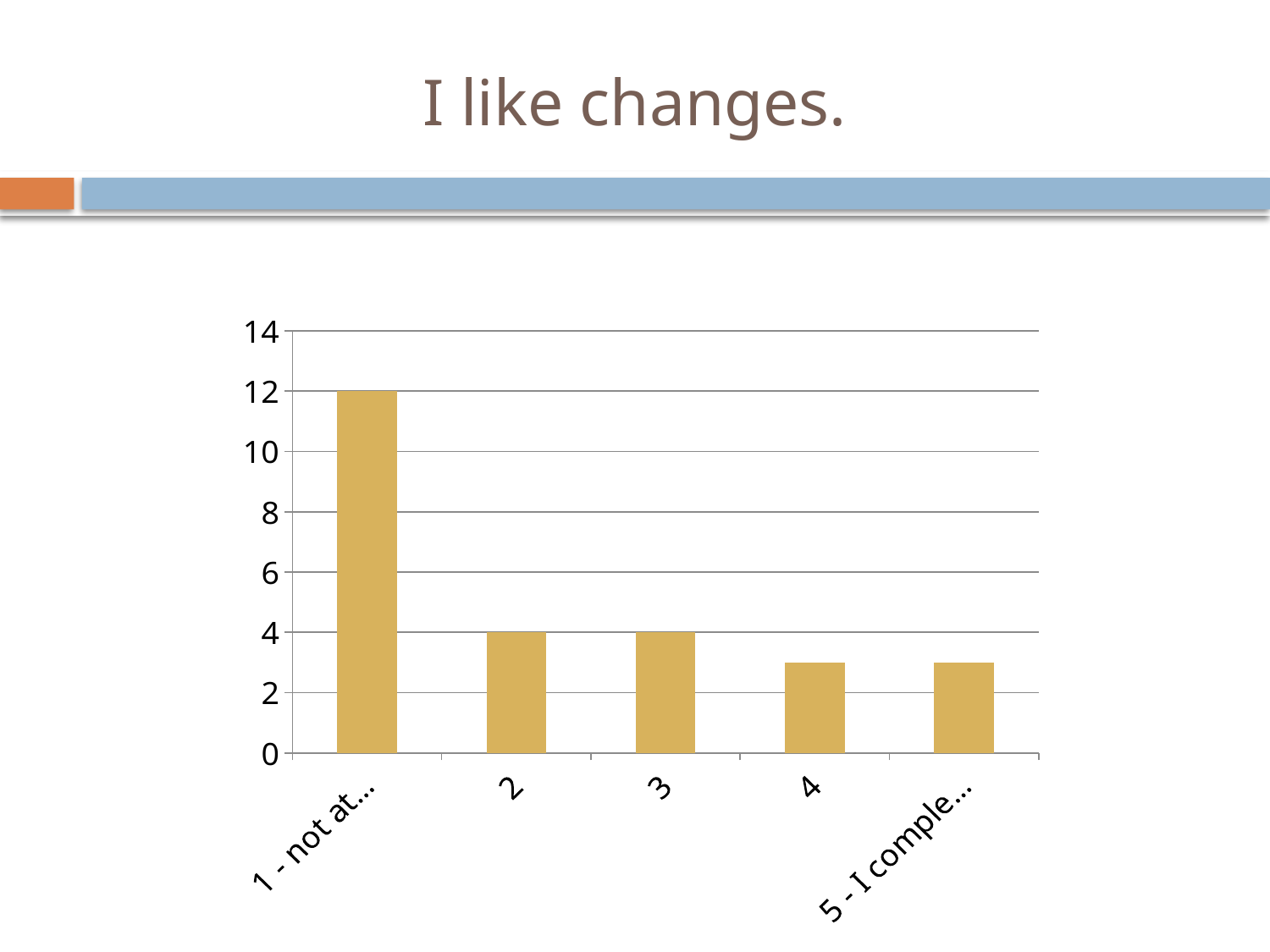
What is the value for category 3? 4 Is the value for the last category, labelled "5 - I comple...", greater or less than 4? less Is the value for category 4 greater or less than 4? less Which category has the highest bar? 1 - not at... How many bars (categories) does the chart show? 5 Which is larger, the value for category 2 or the value for category 4? category 2 What is the difference between the value for "1 - not at..." and the value for category 2? 8 What is the value for category 2? 4 Is the value for category 4 greater or less than 2? greater What is the title of the slide containing the chart? I like changes. What kind of chart is shown on the slide? bar chart What is the value for the first category, labelled "1 - not at..."? 12